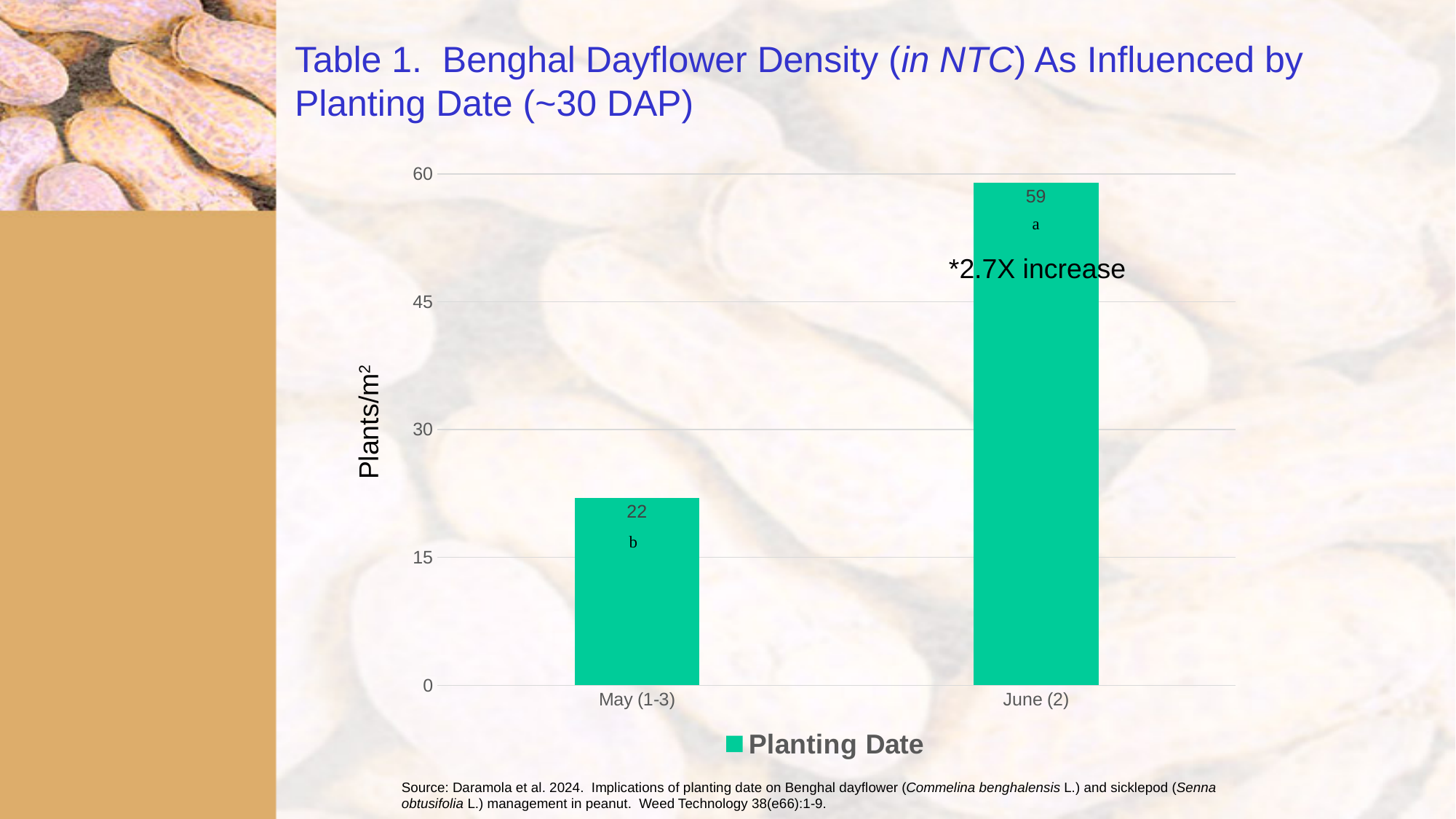
Which planting date has the highest Benghal dayflower density? June (2) How many planting date categories are shown on the chart? 2 How many series does the legend list? 1 What is the Benghal dayflower density (plants/m²) for the June (2) planting date? 59 What is the Benghal dayflower density (plants/m²) for the May (1-3) planting date? 22 What is the label on the y axis of the chart? Plants/m² What kind of chart is shown on the slide? Bar chart Which planting date has the lowest Benghal dayflower density? May (1-3) Is the value for June (2) greater or less than 45? greater What is the difference in plants/m² between the June (2) and May (1-3) planting dates? 37 Is the value for May (1-3) greater or less than 30? less Which planting date has a larger Benghal dayflower density, May (1-3) or June (2)? June (2)